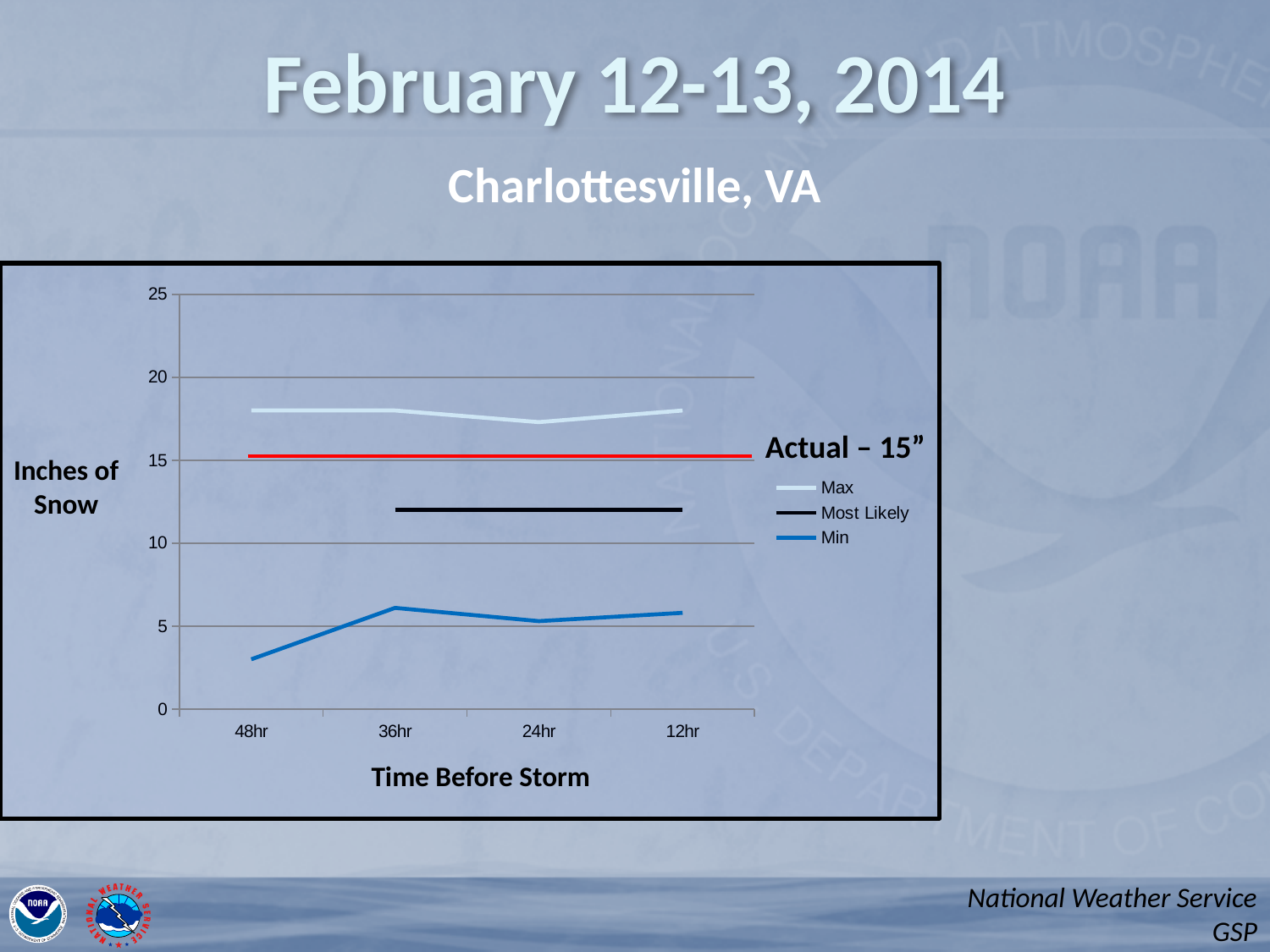
Which series has the highest value at 24hr? Max Does the Min line rise or fall from 48hr to 36hr? rise Is the Min value at 36hr greater or less than 5? greater How many time points are shown on the x axis of the chart? 4 At 12hr, which is larger, the Max value or the Min value? Max What kind of chart is shown on the slide? line chart What is the title of the x axis of the chart? Time Before Storm Is the Min value at 48hr greater or less than 5? less Is the Most Likely value at 24hr greater or less than 15? less How many series does the chart legend list? 3 What actual snowfall amount is marked by the red line on the chart? 15"